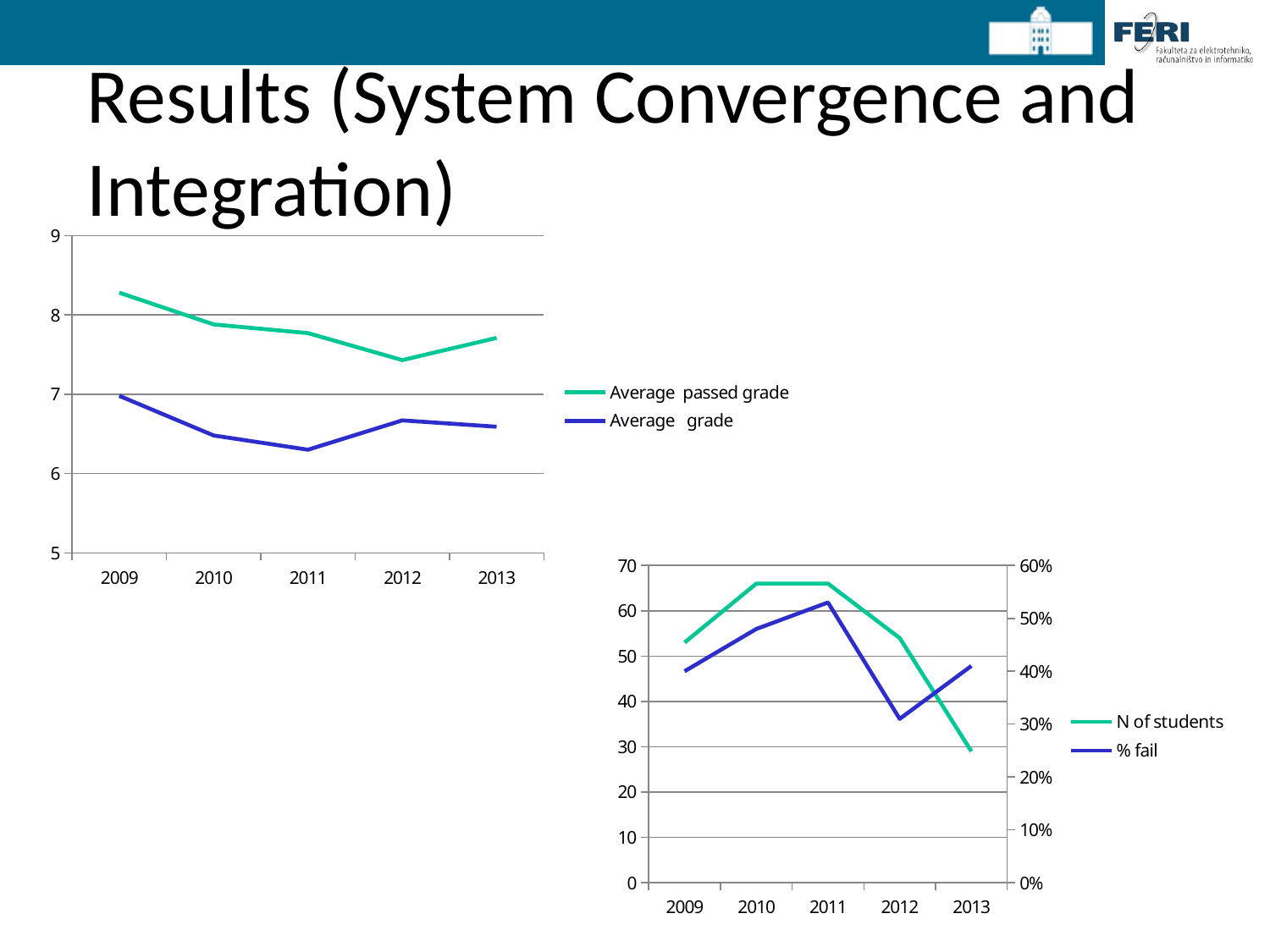
In the bottom-right chart, is the N of students for 2010 greater or less than 60? greater In the top-left chart, which year has the lowest Average passed grade? 2012 What kind of chart is the top-left chart on the slide? line chart How many years are shown on the x axis of the bottom-right chart? 5 In the top-left chart, is the Average passed grade for 2009 greater or less than 8? greater In the bottom-right chart, is the % fail for 2011 greater or less than 50%? greater In the top-left chart, which year has the lowest Average grade? 2011 In the top-left chart, which year has the highest Average passed grade? 2009 In the bottom-right chart, which year has the highest % fail? 2011 In the bottom-right chart, which year has the lowest N of students? 2013 How many series does the legend of the top-left chart list? 2